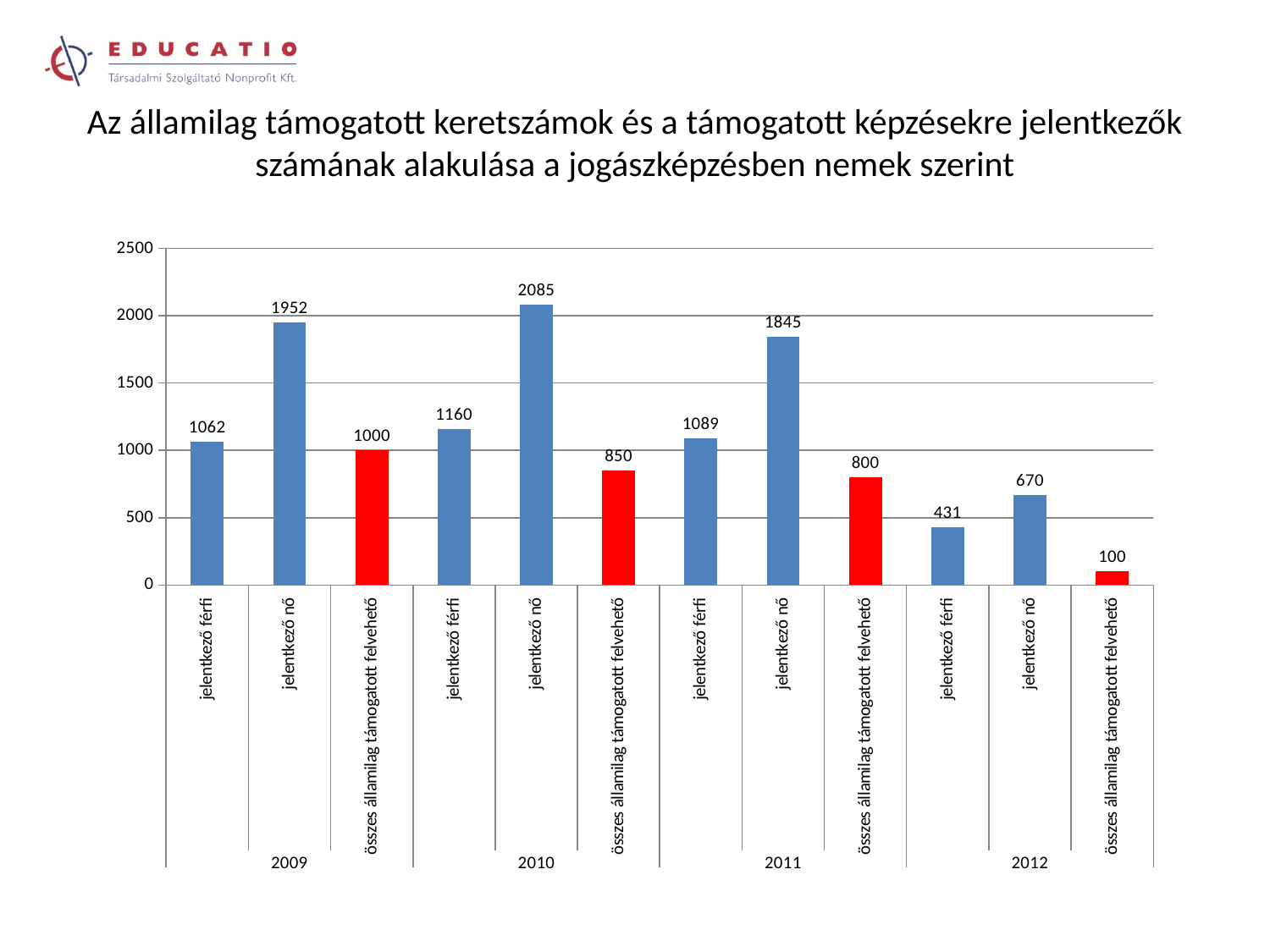
How does the value for "összes államilag támogatott felvehető" change from 2009 to 2012? It falls What is the value for "összes államilag támogatott felvehető" in 2012? 100 What is the value for "jelentkező nő" in 2010? 2085 Which is larger: "jelentkező férfi" in 2010 or "jelentkező férfi" in 2011? jelentkező férfi in 2010 Which bar has the highest value in the chart? jelentkező nő, 2010 Which bar has the lowest value in the chart? összes államilag támogatott felvehető, 2012 Is the value for "jelentkező nő" in 2012 greater or less than 1000? less What is the difference between "összes államilag támogatott felvehető" in 2009 and in 2010? 150 What is the value for "jelentkező férfi" in 2011? 1089 What is the difference between "jelentkező nő" and "jelentkező férfi" in 2009? 890 How many bars are plotted in the chart? 12 What kind of chart is shown on the slide? bar chart